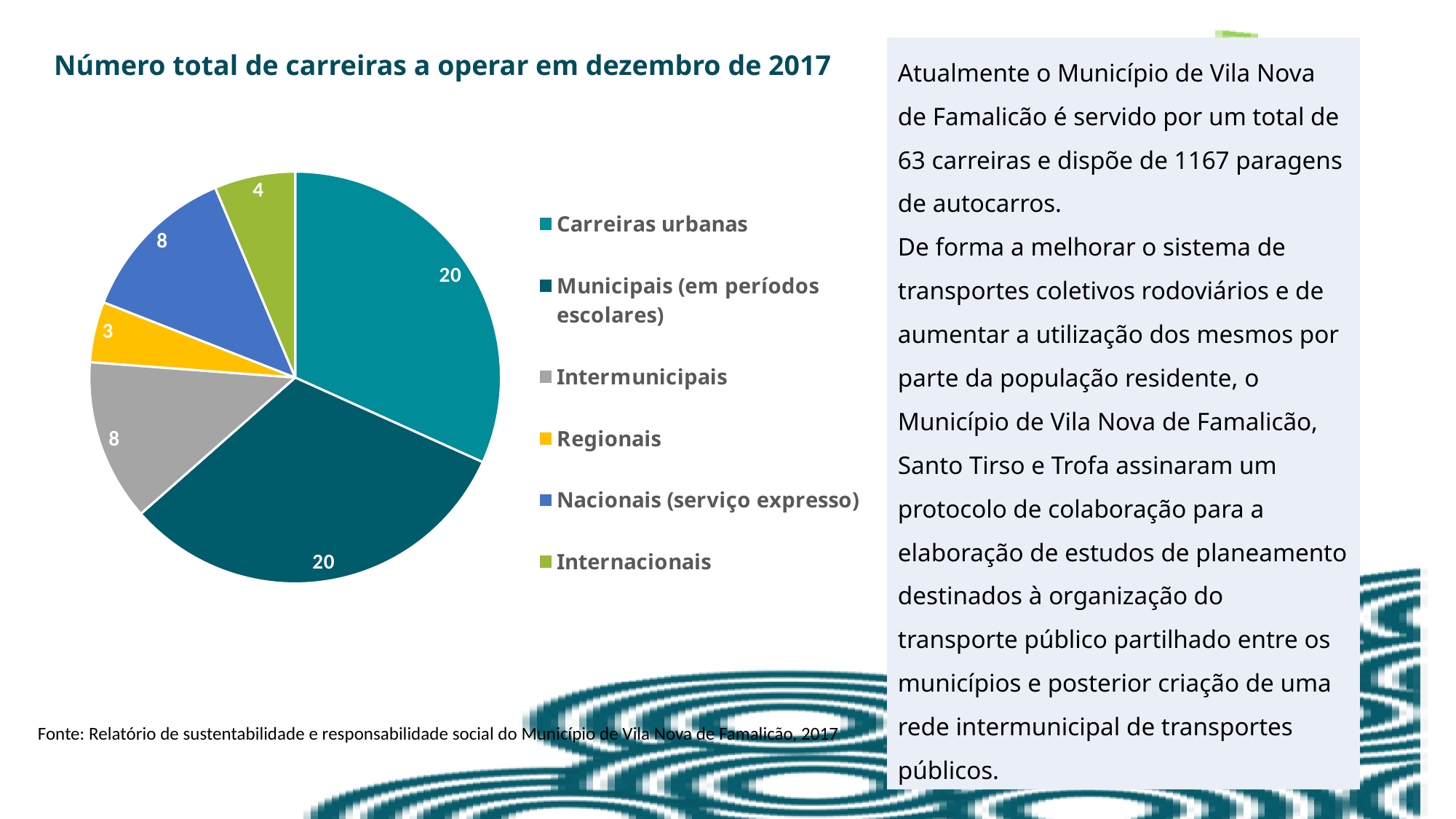
Which is larger, Nacionais (serviço expresso) or Internacionais? Nacionais (serviço expresso) What is the difference between the values for Intermunicipais and Internacionais? 4 What is the title of the chart? Número total de carreiras a operar em dezembro de 2017 What is the value for Internacionais in the pie chart? 4 How many Regionais carreiras are shown in the pie chart? 3 Which category has the smallest slice in the pie chart? Regionais What is the value for Carreiras urbanas in the pie chart? 20 What is the difference between the values for Carreiras urbanas and Regionais? 17 What is the total of all the slices in the pie chart? 63 How many categories does the pie chart show? 6 What is the value for Nacionais (serviço expresso)? 8 What kind of chart is shown on the slide? Pie chart